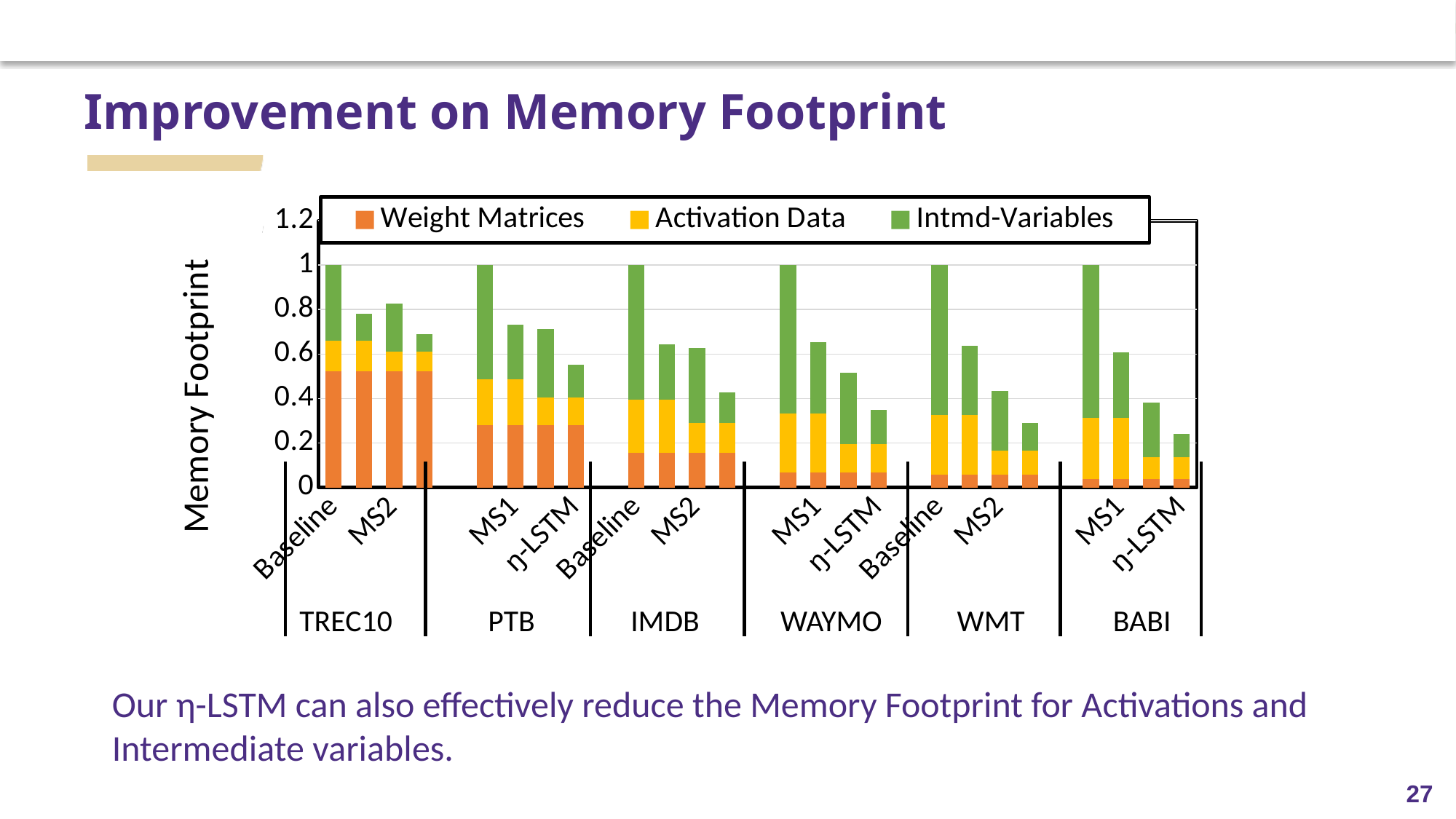
Which bar in the WAYMO group has the lowest total Memory Footprint? η-LSTM Within the PTB group, do the total Memory Footprint values rise or fall from Baseline to η-LSTM? fall Which series is shown in green in the legend? Intmd-Variables Which has the larger total Memory Footprint: η-LSTM in TREC10 or η-LSTM in BABI? η-LSTM in TREC10 Is the total Memory Footprint for η-LSTM in the BABI group greater or less than 0.4? less How many dataset groups are shown along the x axis? 6 What is the total Memory Footprint of the Baseline bar in the TREC10 group? 1 Which bar in the PTB group has the highest total Memory Footprint? Baseline Is the total Memory Footprint for η-LSTM in the WAYMO group greater or less than 0.4? less What kind of chart is shown on the slide? stacked bar chart Is the total Memory Footprint for η-LSTM in the TREC10 group greater or less than 0.6? greater How many series does the legend list? 3